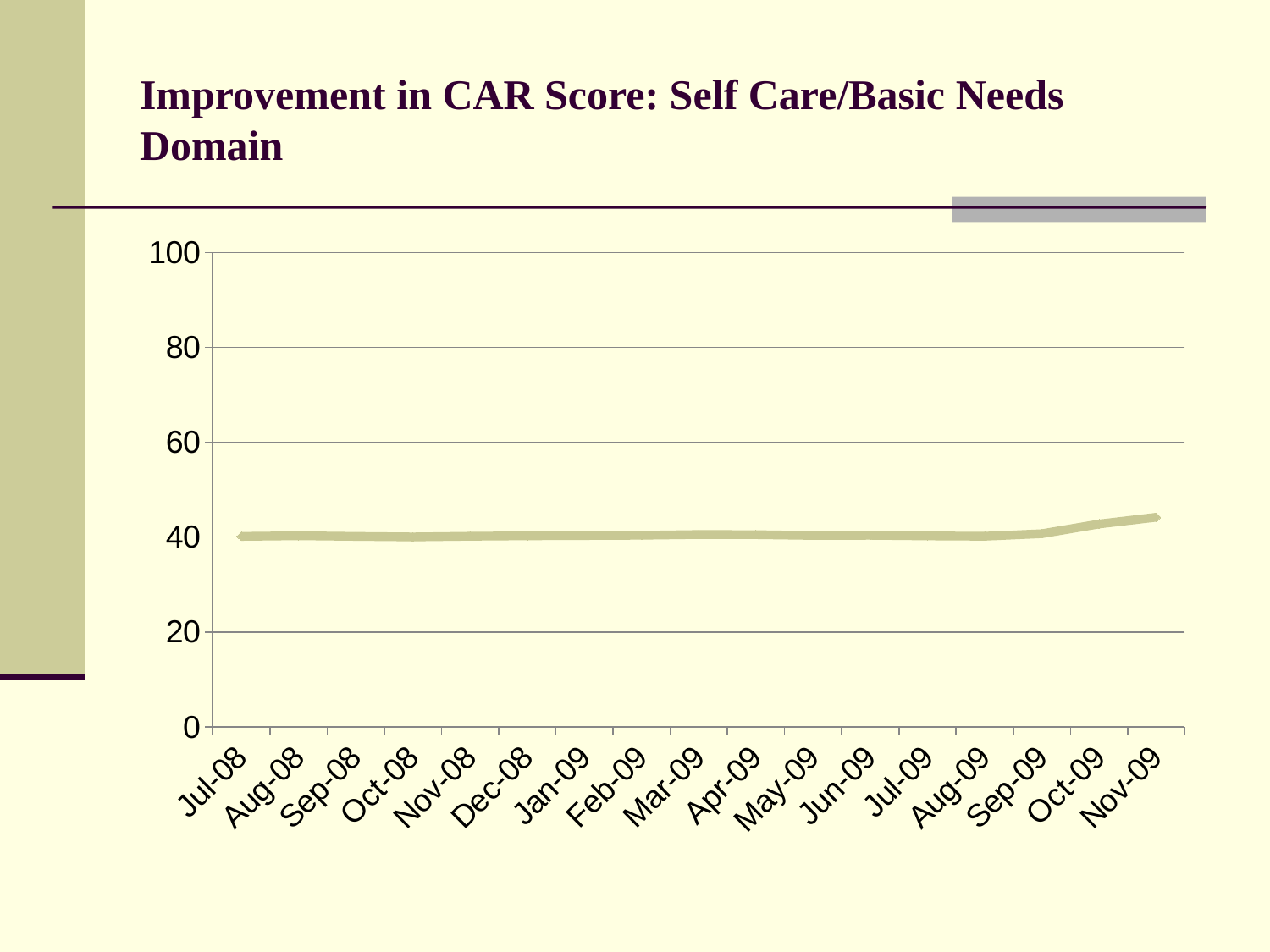
Is the value for Jul-08 greater or less than 60? less Is the value for Mar-09 greater or less than 20? greater Does the line rise or fall between Aug-09 and Nov-09? rise What kind of chart is shown on the slide? line chart Which is larger, the value for Nov-09 or the value for Aug-09? Nov-09 What is the first month shown on the x axis? Jul-08 Which month has the highest value on the line? Nov-09 What is the highest value shown on the y axis? 100 Is the value for Nov-09 greater or less than 60? less How many months are plotted along the x axis? 17 What is the title of the chart on the slide? Improvement in CAR Score: Self Care/Basic Needs Domain